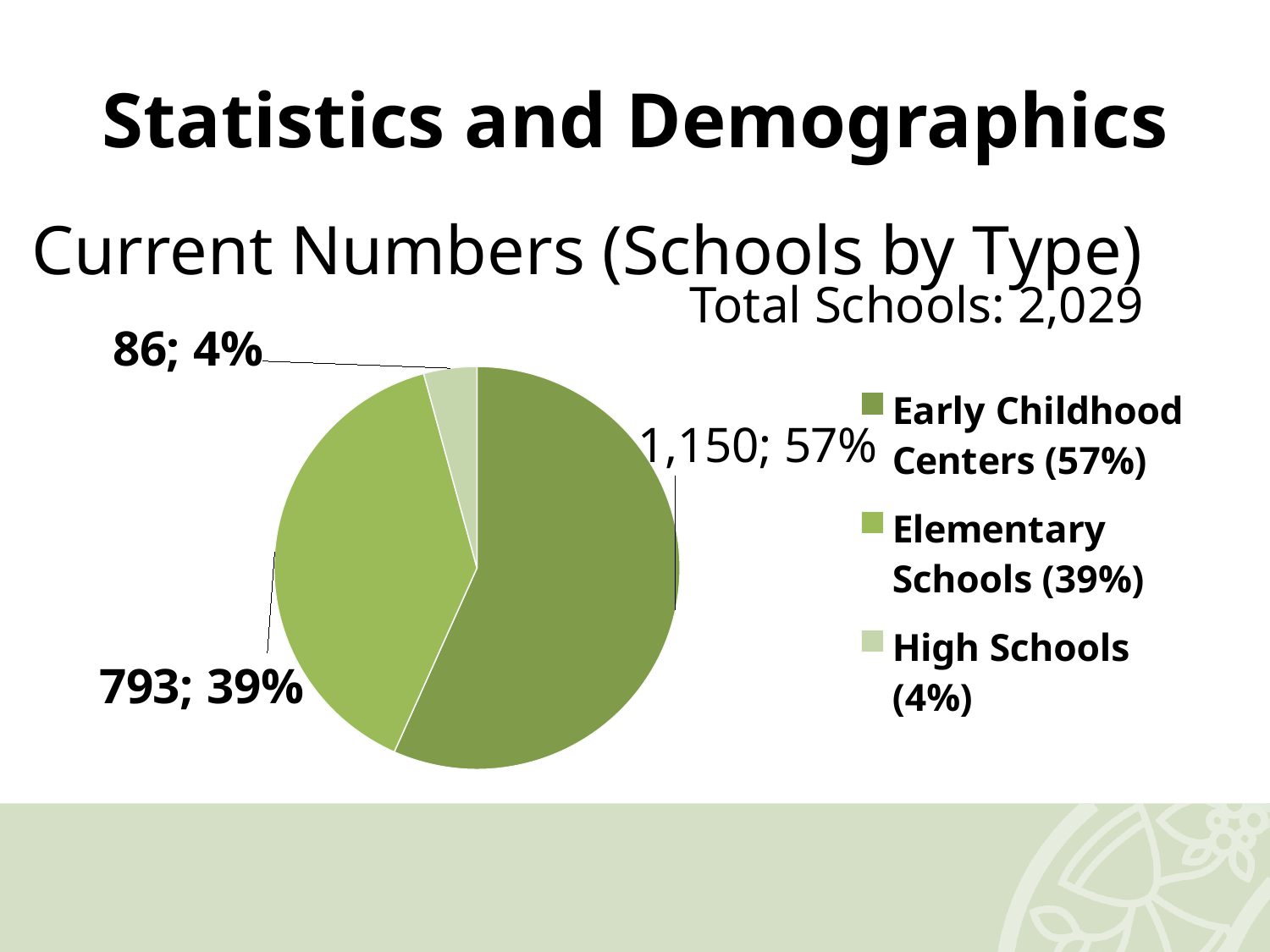
What total number of schools is stated on the slide? 2,029 Which school type has the smallest slice of the pie? High Schools What share of the pie do High Schools make up? 4% What share of the pie do Elementary Schools make up? 39% How many schools are Early Childhood Centers? 1,150 What kind of chart is shown on the slide? pie chart How many schools are Elementary Schools? 793 Which is larger, the number of Elementary Schools or the number of High Schools? Elementary Schools How many schools are High Schools? 86 Which school type has the largest slice of the pie? Early Childhood Centers What is the difference between the number of Early Childhood Centers and Elementary Schools? 357 How many categories does the pie chart show? 3